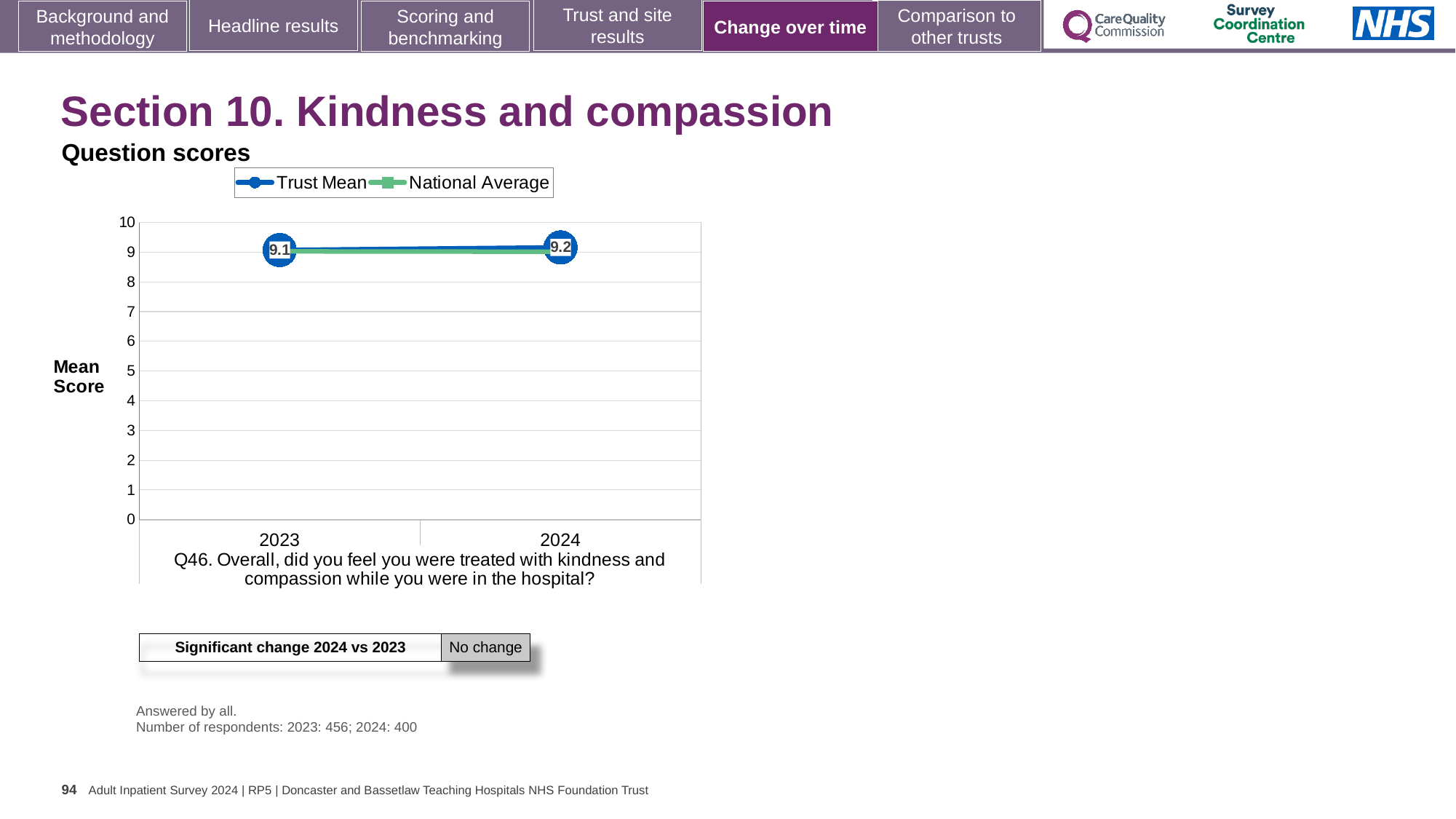
What kind of chart is shown on the slide? line chart How many series does the chart legend list? 2 What are the two series named in the chart legend? Trust Mean and National Average What is the Trust Mean score for 2023? 9.1 Which year has the higher Trust Mean score, 2023 or 2024? 2024 What is the label on the y axis of the chart? Mean Score How many years are plotted on the x axis of the chart? 2 What is the Trust Mean score for 2024? 9.2 Is the National Average value for 2023 greater or less than 8? greater Does the Trust Mean rise or fall from 2023 to 2024? rise Is the Trust Mean value for 2024 greater or less than 5? greater What is the difference between the Trust Mean scores for 2024 and 2023? 0.1